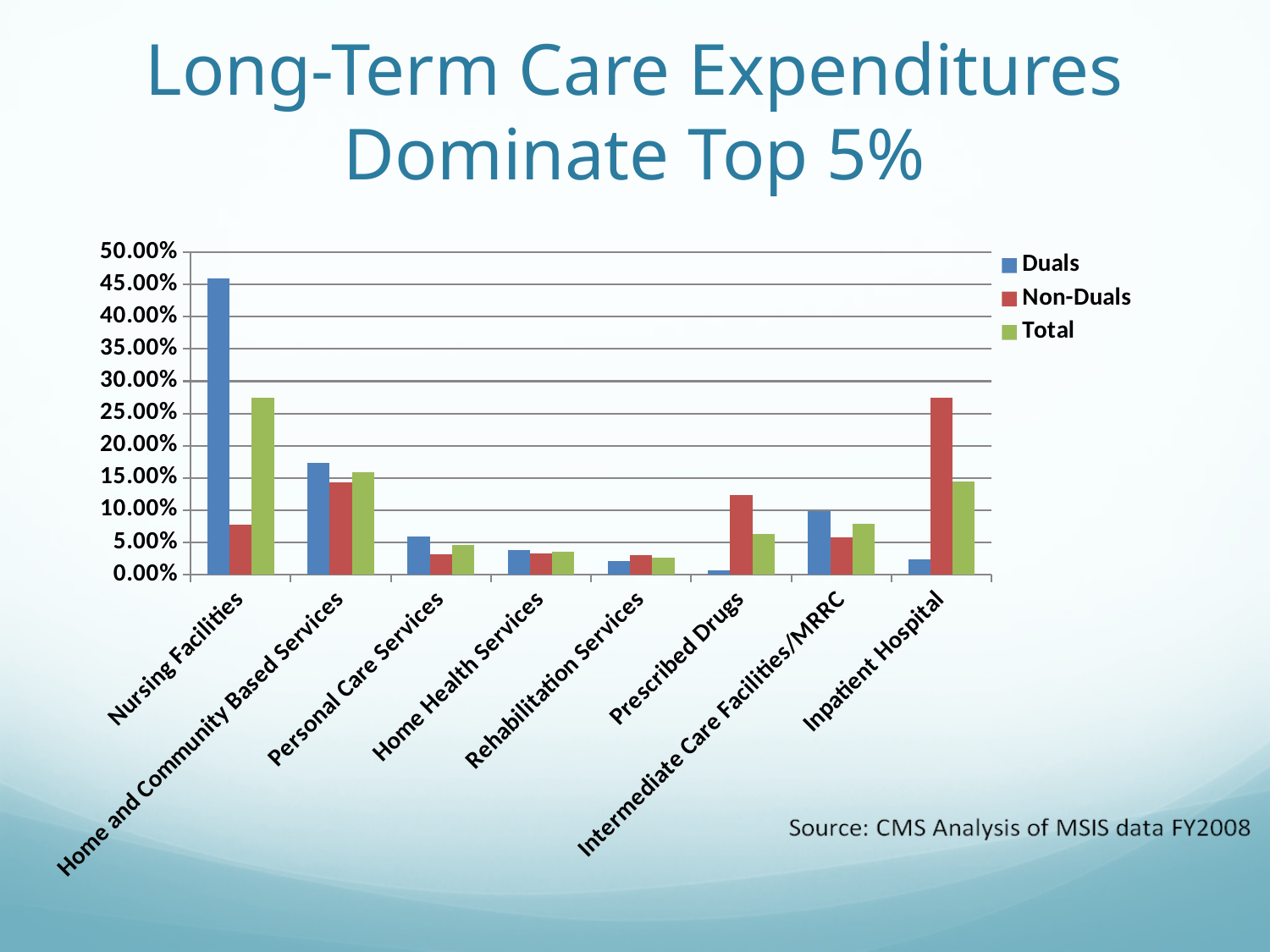
Is the Duals value for Nursing Facilities greater or less than 40.00%? greater For Nursing Facilities, which is larger: the Duals value or the Non-Duals value? Duals How many service categories are shown on the x axis? 8 For Prescribed Drugs, which is larger: the Duals value or the Non-Duals value? Non-Duals Is the Total value for Nursing Facilities greater or less than 20.00%? greater Which category has the lowest Duals value? Prescribed Drugs How many series does the legend list? 3 What kind of chart is shown on the slide? bar chart What colour represents the Total series in the legend? green Is the Non-Duals value for Inpatient Hospital greater or less than 25.00%? greater Which category has the highest Duals value? Nursing Facilities Which category has the highest Non-Duals value? Inpatient Hospital